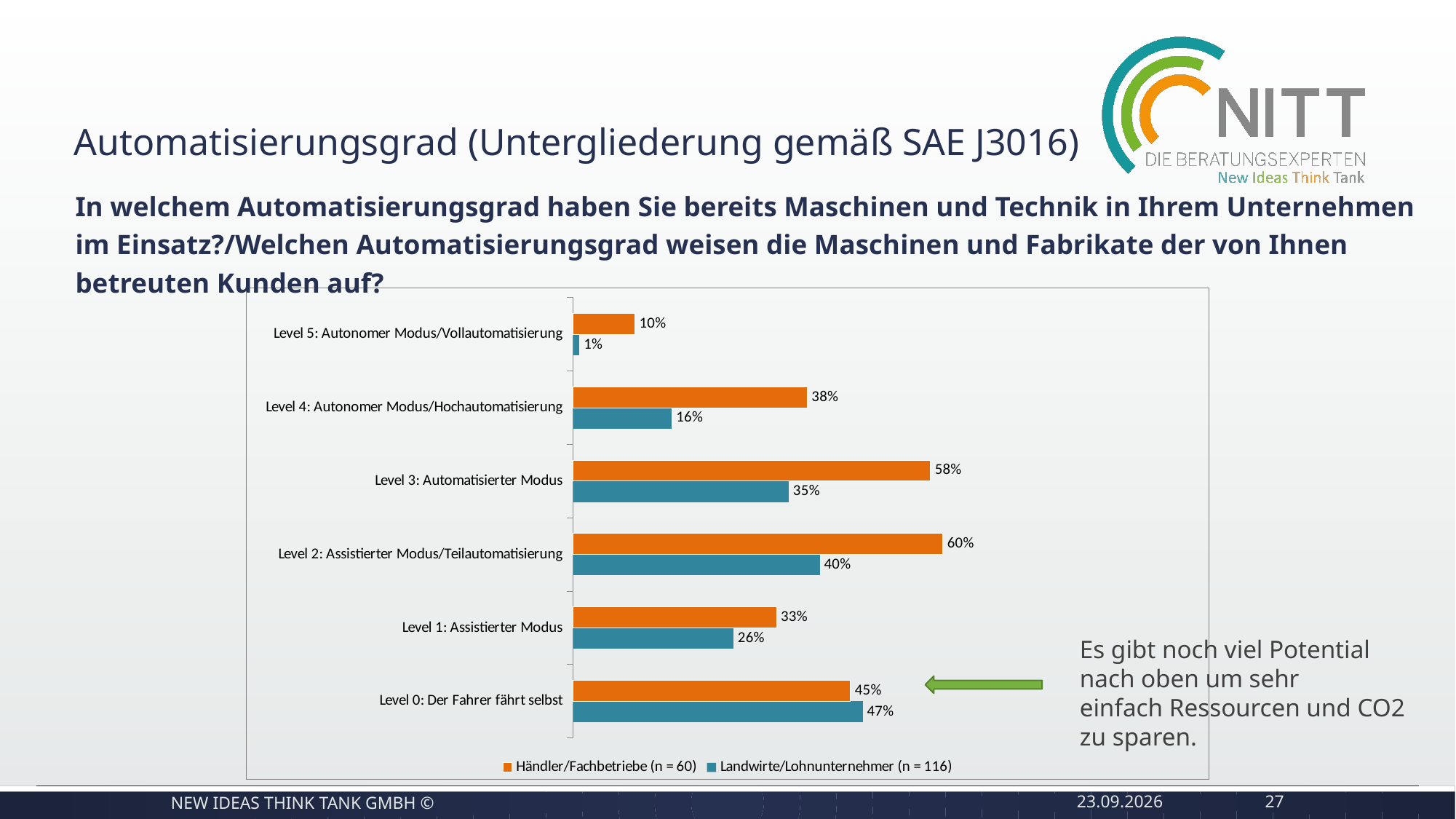
What is the value for Landwirte/Lohnunternehmer (n = 116) at Level 5: Autonomer Modus/Vollautomatisierung? 1% Which colour represents Händler/Fachbetriebe (n = 60) in the chart? Orange Which level has the highest value for Händler/Fachbetriebe (n = 60)? Level 2: Assistierter Modus/Teilautomatisierung What is the value for Händler/Fachbetriebe (n = 60) at Level 1: Assistierter Modus? 33% How many levels (categories) are shown in the chart? 6 What is the value for Landwirte/Lohnunternehmer (n = 116) at Level 0: Der Fahrer fährt selbst? 47% How many series does the legend list? 2 Which level has the lowest value for Landwirte/Lohnunternehmer (n = 116)? Level 5: Autonomer Modus/Vollautomatisierung What is the value for Händler/Fachbetriebe (n = 60) at Level 3: Automatisierter Modus? 58% At Level 0: Der Fahrer fährt selbst, which series has the larger value, Händler/Fachbetriebe or Landwirte/Lohnunternehmer? Landwirte/Lohnunternehmer (n = 116) What is the difference between the Händler/Fachbetriebe and Landwirte/Lohnunternehmer values at Level 4: Autonomer Modus/Hochautomatisierung? 22% What kind of chart is shown on the slide? Bar chart